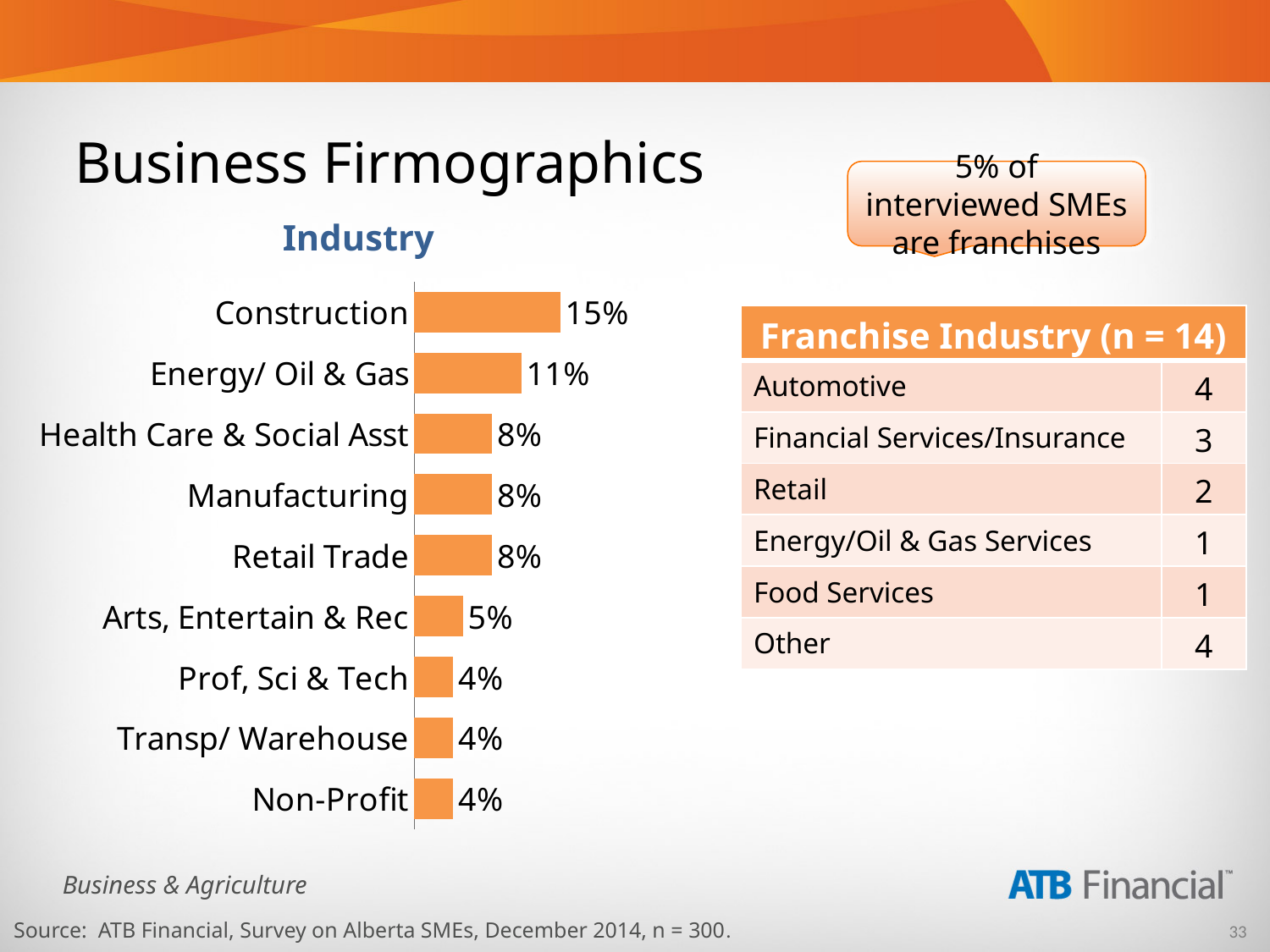
Which category has the highest value in the Industry chart? Construction What is the value for Construction in the Industry chart? 15% What is the value for Arts, Entertain & Rec in the Industry chart? 5% In the Industry chart, which is larger: Health Care & Social Asst or Transp/ Warehouse? Health Care & Social Asst How many categories in the Industry chart have a value of 8%? 3 What colour are the bars in the Industry chart? Orange What is the value for Non-Profit in the Industry chart? 4% What is the value for Energy/ Oil & Gas in the Industry chart? 11% What is the difference between the values for Construction and Energy/ Oil & Gas in the Industry chart? 4% What kind of chart is the Industry chart? Bar chart How many categories are shown in the Industry chart? 9 What is the difference between the values for Manufacturing and Prof, Sci & Tech in the Industry chart? 4%